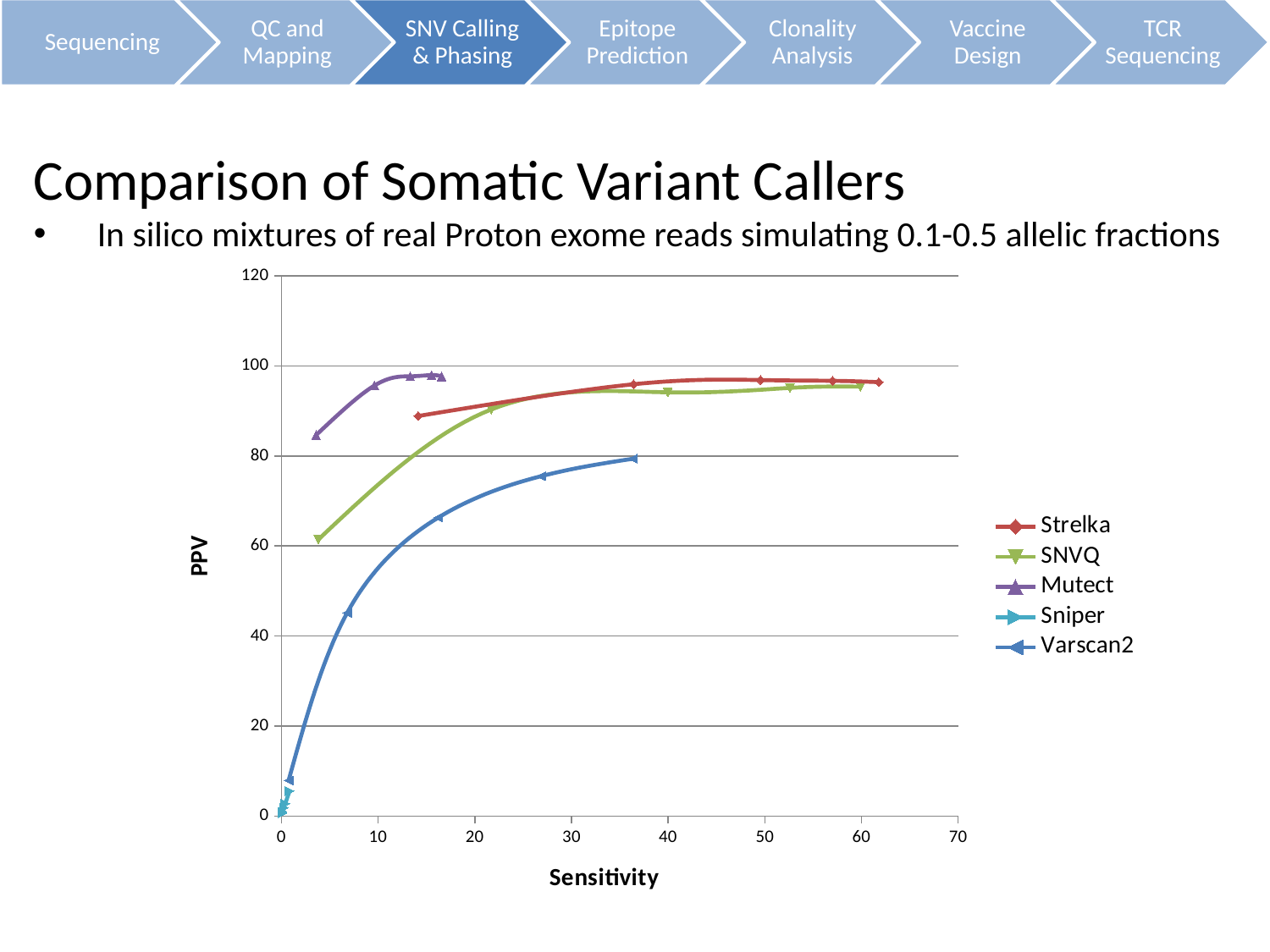
What is the label of the y axis? PPV Is the first (leftmost) PPV value of SNVQ greater or less than 80? less What is the label of the x axis? Sensitivity Which series has the lowest PPV values on the chart? Sniper Which series extends to the highest sensitivity value? Strelka Is the PPV of Varscan2 at a sensitivity of about 27 greater or less than 80? less At a sensitivity of about 10, which series has the higher PPV, Mutect or Varscan2? Mutect Is the highest PPV reached by Mutect greater or less than 90? greater Does the PPV of Varscan2 rise or fall as sensitivity increases? rise What kind of chart is shown on the slide? line chart How many series does the legend list? 5